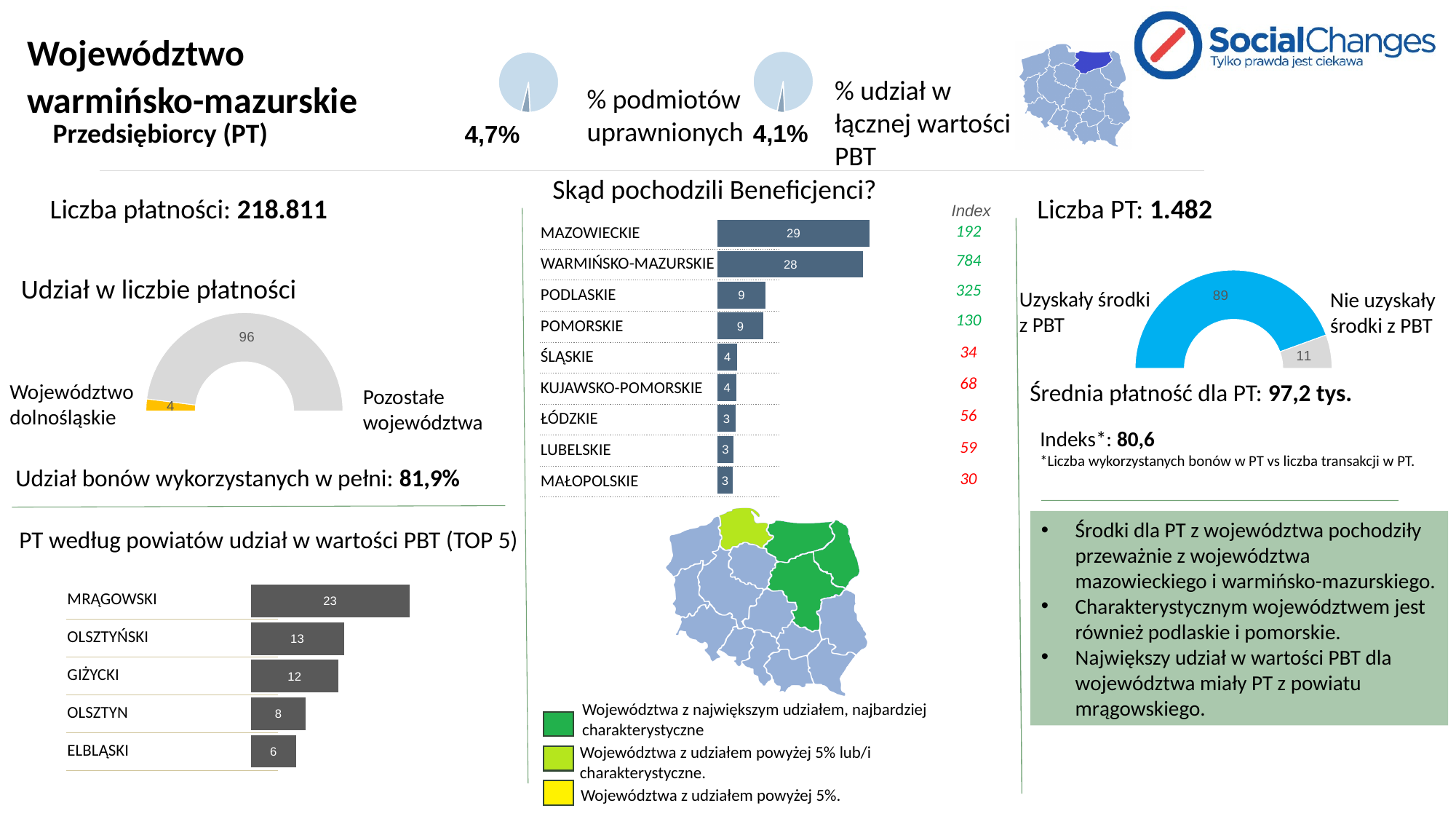
In the 'PT według powiatów udział w wartości PBT (TOP 5)' chart, what is the value for MRĄGOWSKI? 23 In the 'Skąd pochodzili Beneficjenci?' chart, what is the difference between the values for MAZOWIECKIE and PODLASKIE? 20 In the 'Udział w liczbie płatności' chart, what is the value for 'Pozostałe województwa'? 96 In the 'PT według powiatów udział w wartości PBT (TOP 5)' chart, which is larger, OLSZTYŃSKI or OLSZTYN? OLSZTYŃSKI In the chart next to 'Liczba PT', what is the value for 'Nie uzyskały środki z PBT'? 11 In the 'Skąd pochodzili Beneficjenci?' chart, what is the value for WARMIŃSKO-MAZURSKIE? 28 In the 'Skąd pochodzili Beneficjenci?' chart, which category has the highest value? MAZOWIECKIE In the 'Skąd pochodzili Beneficjenci?' chart, what is the value for MAZOWIECKIE? 29 In the 'PT według powiatów udział w wartości PBT (TOP 5)' chart, what is the difference between OLSZTYŃSKI and GIŻYCKI? 1 In the 'PT według powiatów udział w wartości PBT (TOP 5)' chart, which category has the lowest value? ELBLĄSKI In the 'Skąd pochodzili Beneficjenci?' chart, how many categories are shown? 9 What kind of chart is 'PT według powiatów udział w wartości PBT (TOP 5)'? bar chart